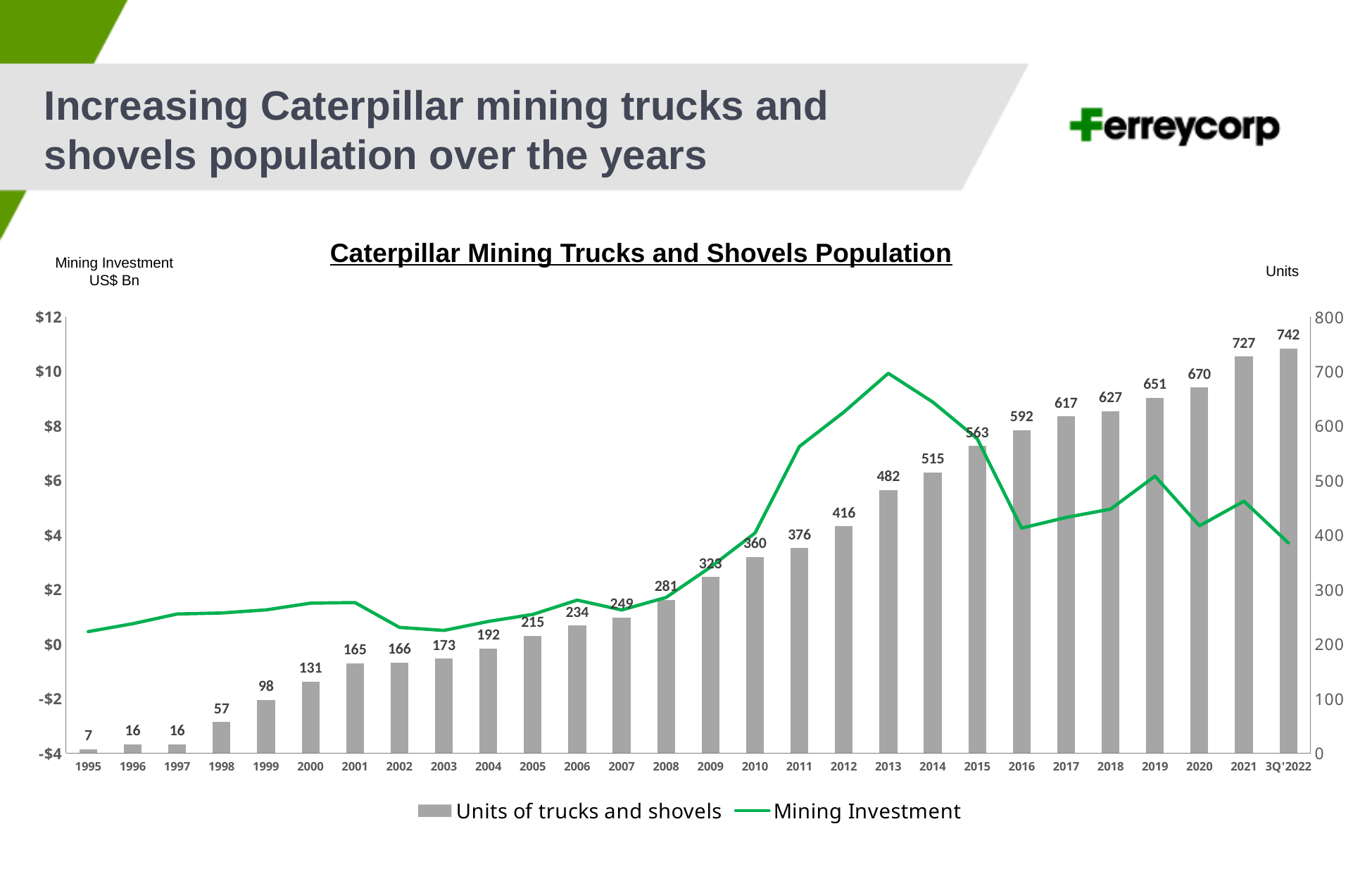
What is the difference in Units of trucks and shovels between 2013 and 2012? 66 Which year has more Units of trucks and shovels, 2005 or 2006? 2006 What is the difference in Units of trucks and shovels between 2021 and 2020? 57 Which year has the lowest value for Units of trucks and shovels? 1995 How many units of trucks and shovels are shown for 2016? 592 Which year has the highest value for Units of trucks and shovels? 3Q'2022 Is the Mining Investment value for 2013 greater or less than $8? greater What is the value for Units of trucks and shovels in 1999? 98 How many series does the legend list? 2 What kind of chart is shown on the slide? Combined bar and line chart What is the value for Units of trucks and shovels in 2010? 360 Is the Mining Investment value for 2003 greater or less than $2? less